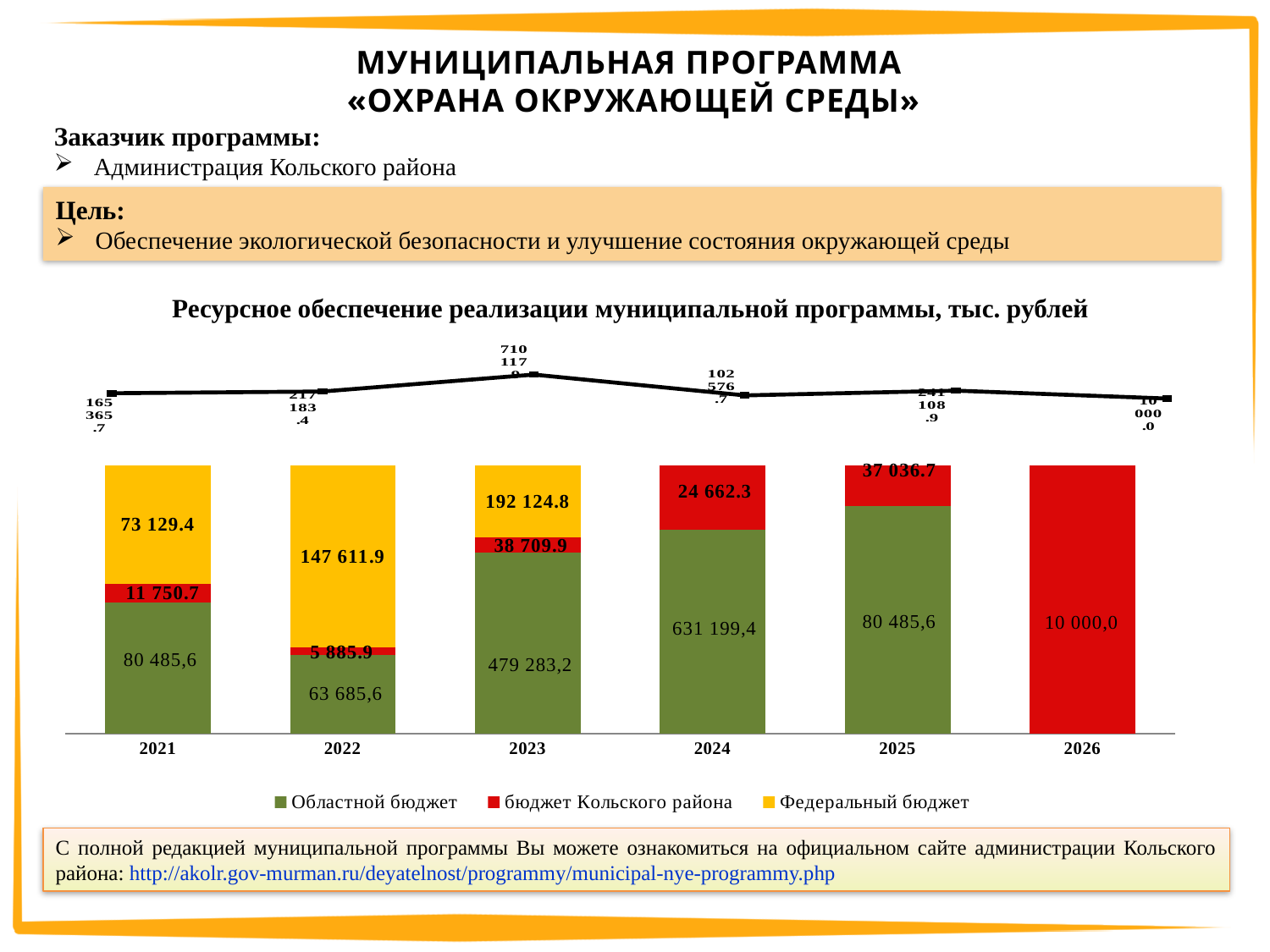
What is the value of бюджет Кольского района for 2026? 10 000,0 What is the value of Федеральный бюджет for 2022? 147 611.9 In which year is the Федеральный бюджет value the highest? 2023 What kind of chart is used to show the budget values? Stacked bar chart How many years are shown on the x axis of the chart? 6 What is the difference between the Областной бюджет values for 2024 and 2023? 151 916,2 What is the value of бюджет Кольского района for 2025? 37 036.7 Which is larger for 2021: Областной бюджет or Федеральный бюджет? Областной бюджет In which year is the бюджет Кольского района value the lowest? 2022 What is the total of the stacked bar for 2022? 217 183.4 How many series does the chart legend list? 3 What is the value of Областной бюджет for 2023? 479 283,2